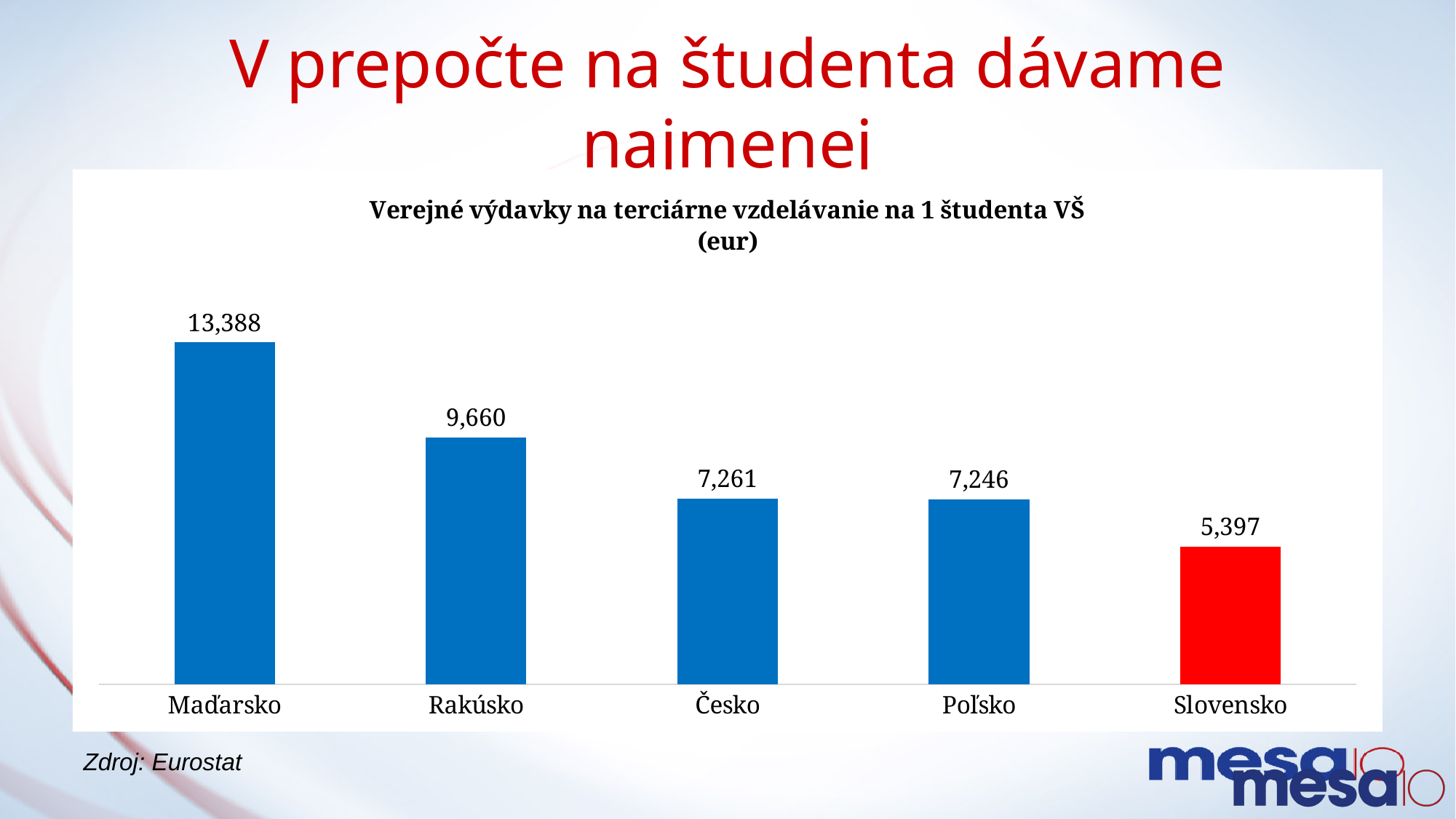
What is the difference between the values for Česko and Poľsko? 15 Which bar is coloured red? Slovensko Which country has the lowest value? Slovensko Which country has the highest value? Maďarsko What is the value for Maďarsko? 13,388 What is the value for Poľsko? 7,246 Which is larger, the value for Rakúsko or the value for Česko? Rakúsko What kind of chart is shown on the slide? Bar chart What is the value for Slovensko? 5,397 What is the difference between the values for Maďarsko and Slovensko? 7,991 How many countries are shown in the chart? 5 What is the value for Rakúsko? 9,660